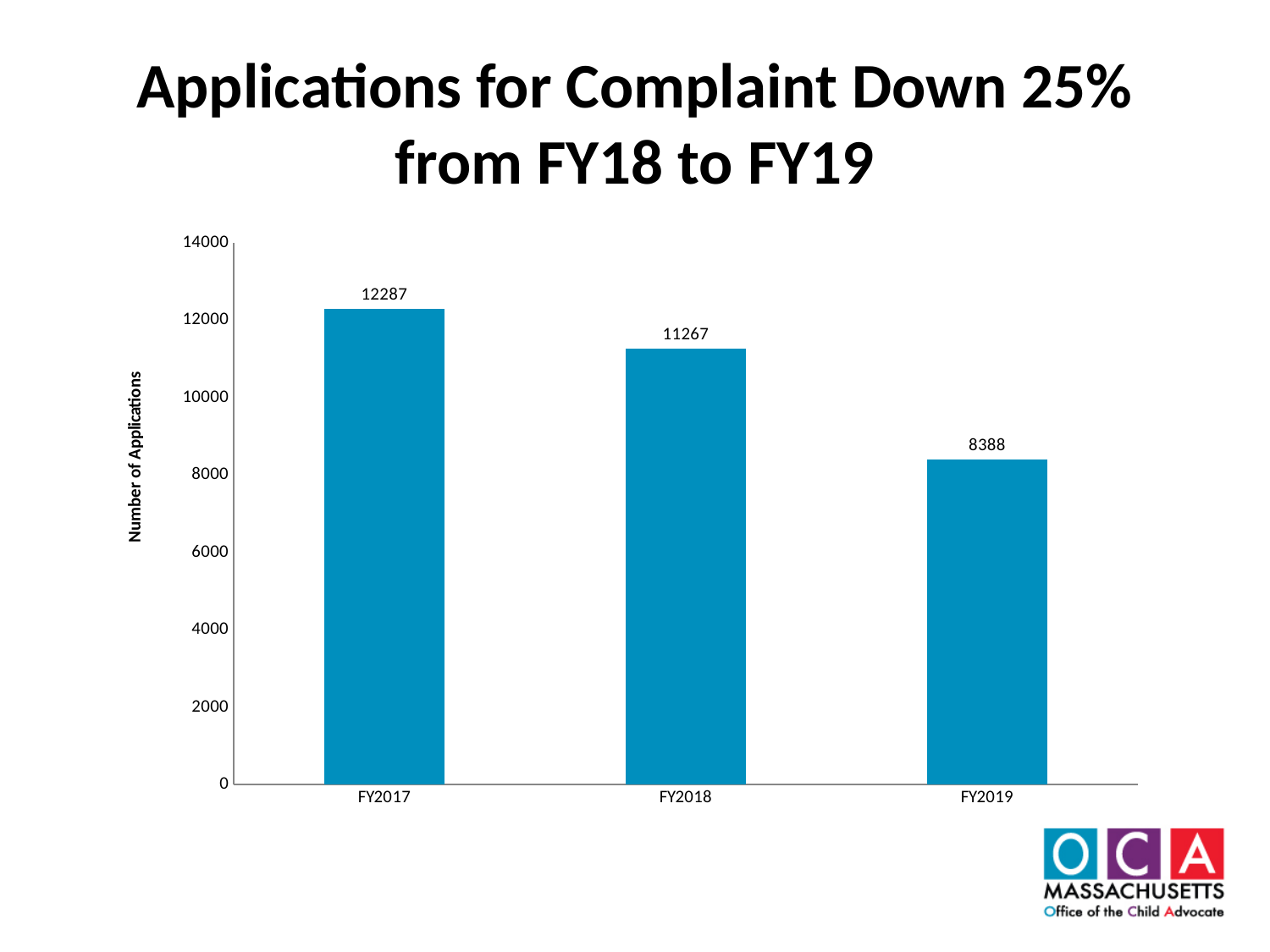
Is the value for FY2019 greater or less than 10000? less What is the number of applications for FY2017? 12287 Which has more applications, FY2017 or FY2019? FY2017 What is the number of applications for FY2018? 11267 How many fiscal years are shown on the chart? 3 What kind of chart is shown on the slide? bar chart Which fiscal year has the lowest number of applications? FY2019 What is the number of applications for FY2019? 8388 Which fiscal year has the highest number of applications? FY2017 What is the difference in the number of applications between FY2017 and FY2018? 1020 What is the difference in the number of applications between FY2018 and FY2019? 2879 Do the values rise or fall from FY2017 to FY2019? fall